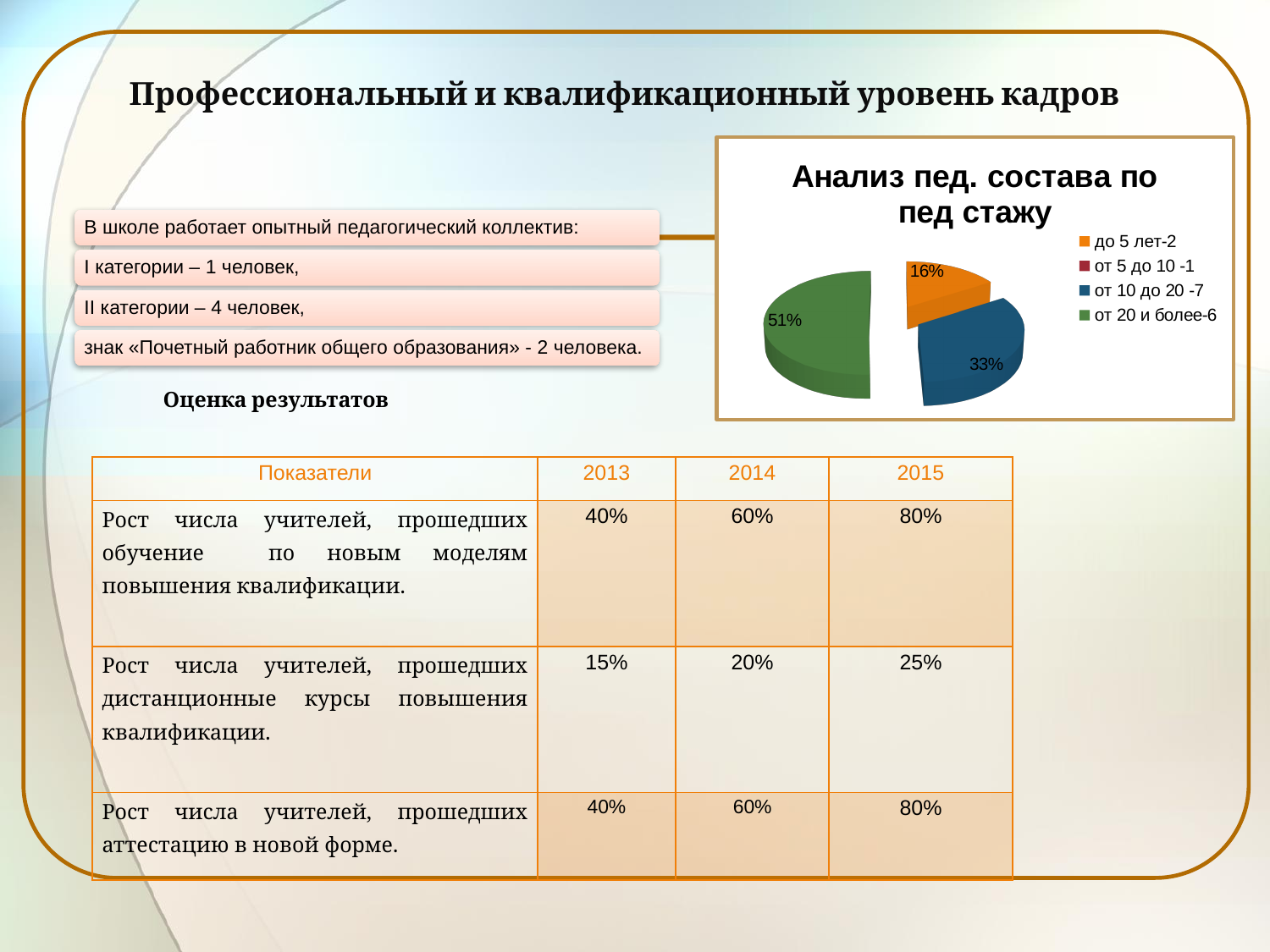
What percentage is shown for the orange slice (до 5 лет-2) in the pie chart? 16% What share of the pie does the slice labelled от 20 и более-6 take? 51% What kind of chart is shown on the slide? pie chart Which legend category has the largest slice in the pie chart? от 20 и более-6 What is the difference in percentage points between the blue slice (33%) and the orange slice (16%)? 17 What is the title of the pie chart? Анализ пед. состава по пед стажу How many entries does the legend of the pie chart list? 4 What percentage is shown for the blue slice (от 10 до 20 -7) in the pie chart? 33% Which slice is larger in the pie chart: от 20 и более-6 or от 10 до 20 -7? от 20 и более-6 What colour is the largest slice of the pie chart? green What is the difference in percentage points between the green slice (51%) and the blue slice (33%)? 18 What percentage is shown for the green slice (от 20 и более-6) in the pie chart? 51%